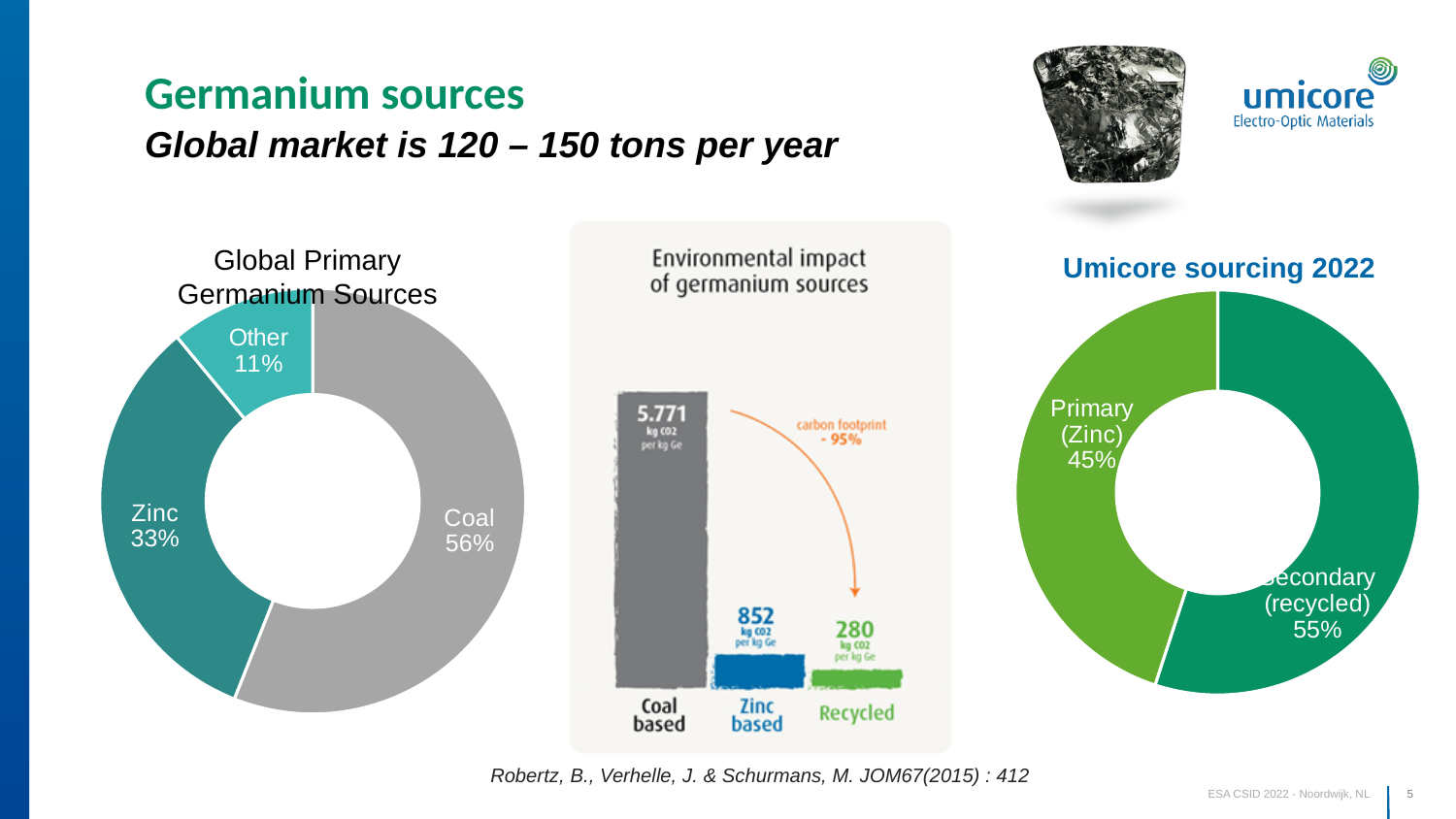
In the Environmental impact of germanium sources chart, which source has the highest carbon footprint? Coal based In the Umicore sourcing 2022 chart, which is larger, Primary (Zinc) or Secondary (recycled)? Secondary (recycled) In the Global Primary Germanium Sources chart, what share does Zinc have? 33% In the Global Primary Germanium Sources chart, which source has the smallest share? Other In the Environmental impact of germanium sources chart, what is the value for Coal based? 5.771 kg CO2 per kg Ge In the Umicore sourcing 2022 chart, what share is Secondary (recycled)? 55% In the Environmental impact of germanium sources chart, what is the value for Recycled? 280 kg CO2 per kg Ge What kind of chart is the Umicore sourcing 2022 chart? Donut (pie) chart In the Global Primary Germanium Sources chart, how many slices are there? 3 In the Global Primary Germanium Sources chart, what is the difference between the Coal and Zinc shares? 23% In the Global Primary Germanium Sources chart, what share does Coal have? 56% What kind of chart is the Environmental impact of germanium sources chart? Bar chart